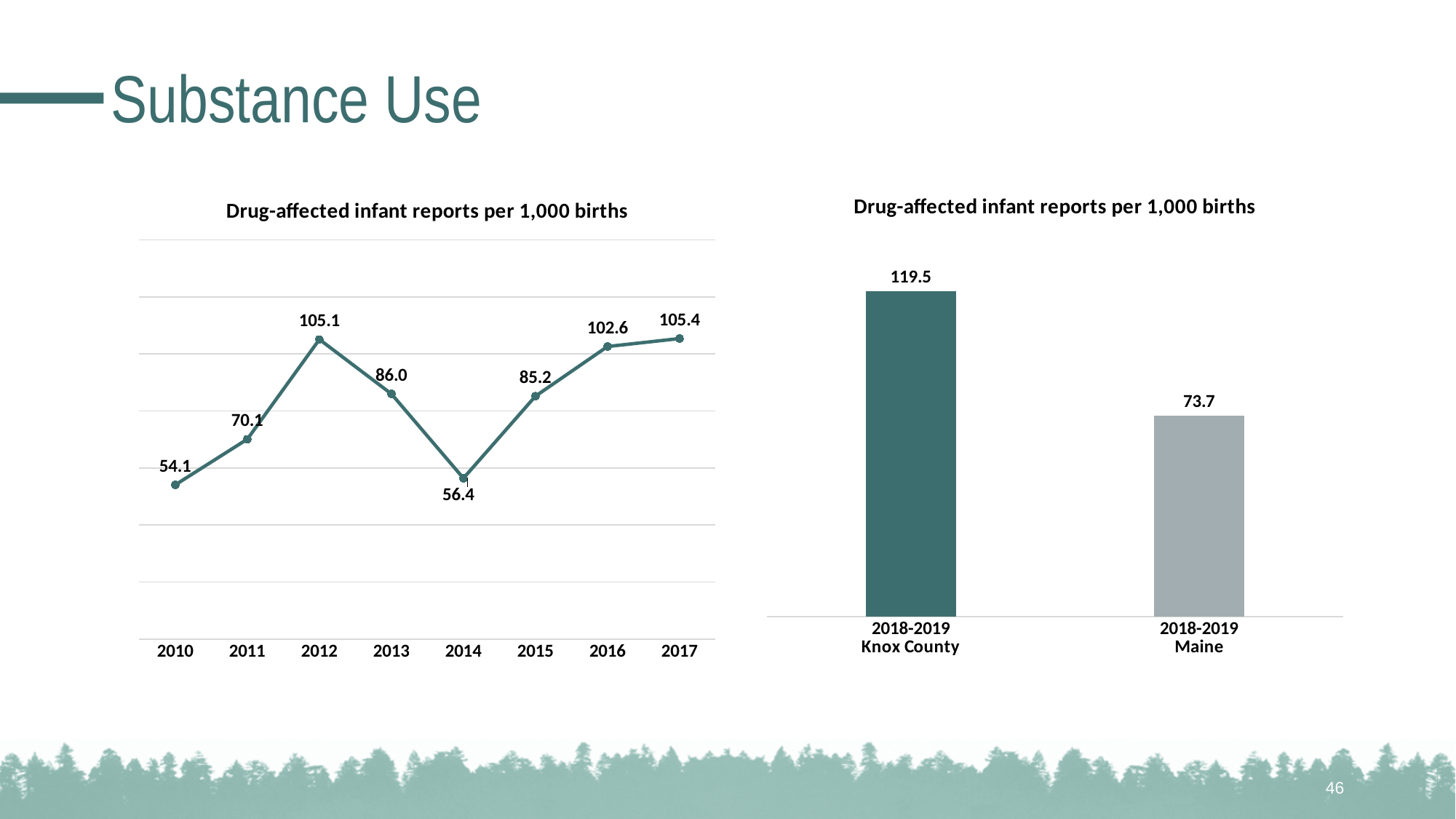
In the left chart, which year has the highest value? 2017 What kind of chart is the right chart? bar chart In the left chart, what was the drug-affected infant report rate per 1,000 births in 2012? 105.1 In the right chart, what is the difference between the Knox County value and the Maine value? 45.8 In the right chart, what is the value for 2018-2019 Knox County? 119.5 What kind of chart is the left chart? line chart In the left chart, did the value rise or fall from 2013 to 2014? fall How many years are plotted in the left chart? 8 In the left chart, what value is shown for 2014? 56.4 In the left chart, what is the difference between the 2012 value and the 2013 value? 19.1 In the left chart, which is larger, the value for 2011 or the value for 2015? 2015 In the left chart, which year has the lowest value? 2010